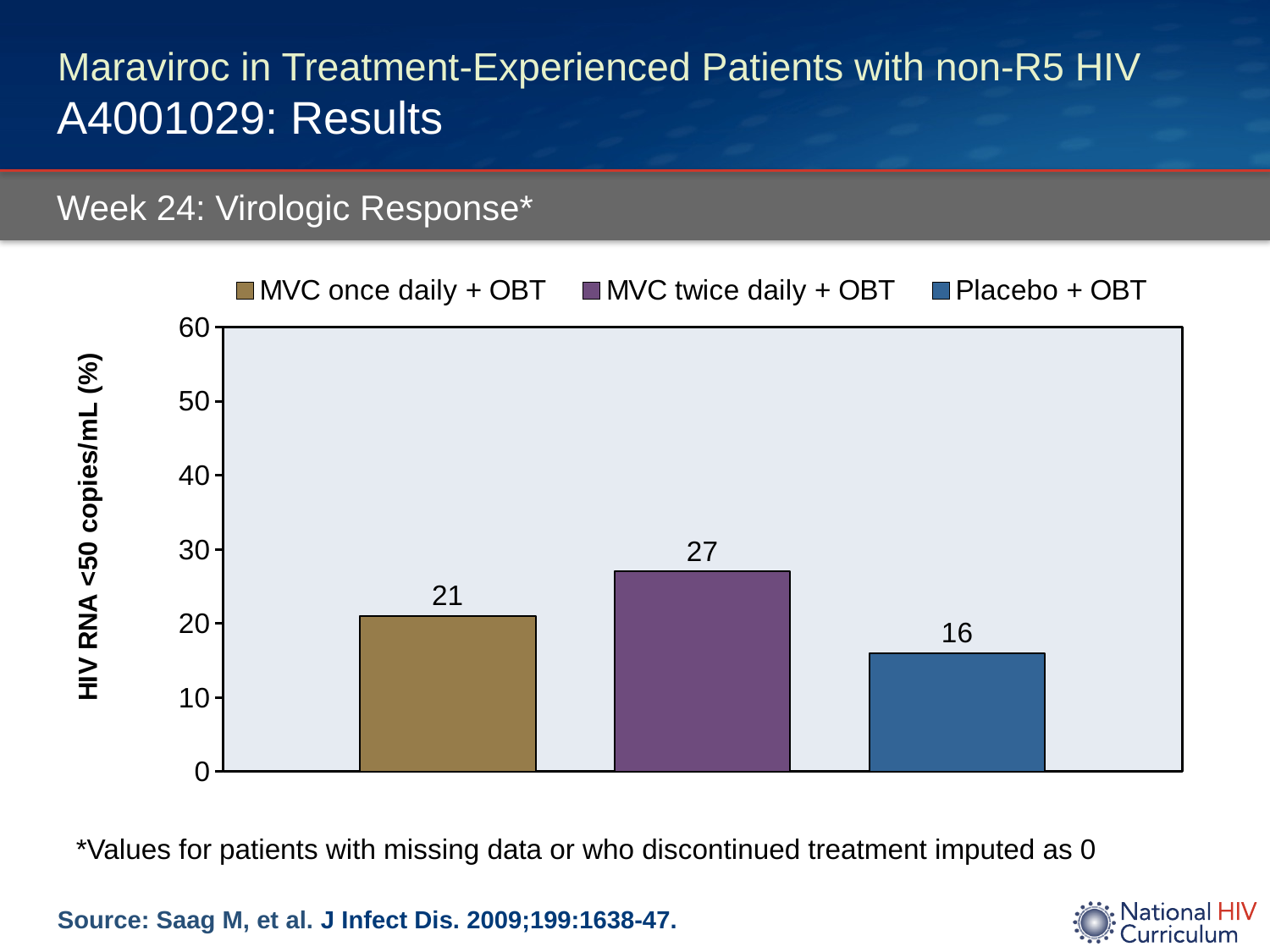
What is the difference between MVC twice daily + OBT and MVC once daily + OBT? 6 How many series does the legend list? 3 Is the value for MVC twice daily + OBT greater or less than 30? less What is the value for Placebo + OBT? 16 What is the value for MVC twice daily + OBT? 27 Which is larger, MVC once daily + OBT or Placebo + OBT? MVC once daily + OBT What kind of chart is shown? bar chart What is the label of the y axis? HIV RNA <50 copies/mL (%) Which group has the lowest virologic response? Placebo + OBT What is the difference between MVC twice daily + OBT and Placebo + OBT? 11 What is the value for MVC once daily + OBT? 21 Which group has the highest virologic response? MVC twice daily + OBT